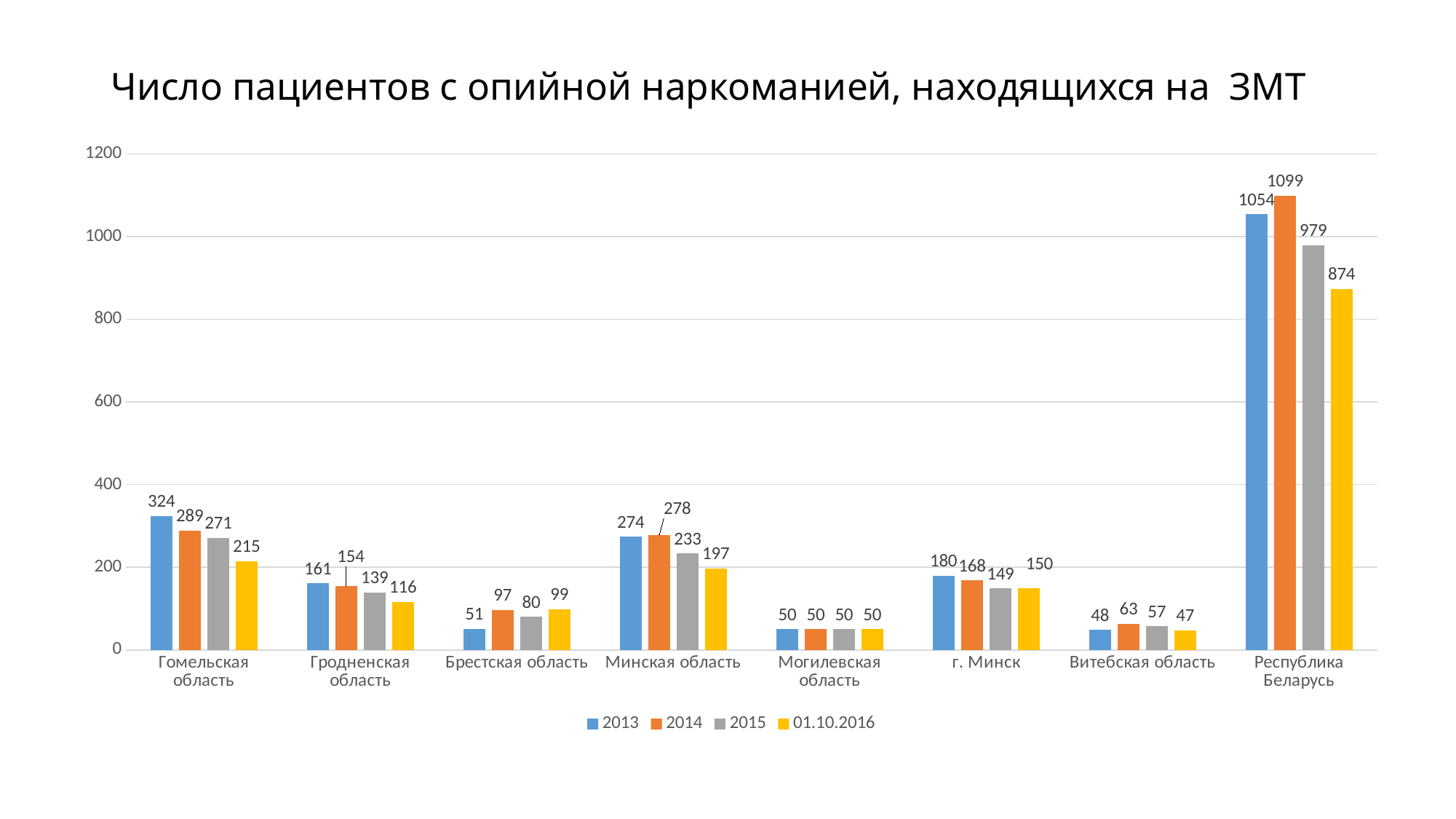
How many series does the legend list? 4 Is the value for Республика Беларусь in 2013 greater or less than 1000? greater Which category has the highest value in 2015? Республика Беларусь What kind of chart is shown on the slide? bar chart Which is larger for Брестская область: the 2014 value or the 2015 value? 2014 What is the value for Гомельская область in 2013? 324 What is the value for Минская область on 01.10.2016? 197 What is the difference between the 2014 and 2015 values for Республика Беларусь? 120 Which category has the lowest value in 2013? Витебская область How many categories are shown on the x axis? 8 What is the difference between the 2013 and 01.10.2016 values for Гомельская область? 109 What is the value for Республика Беларусь in 2014? 1099